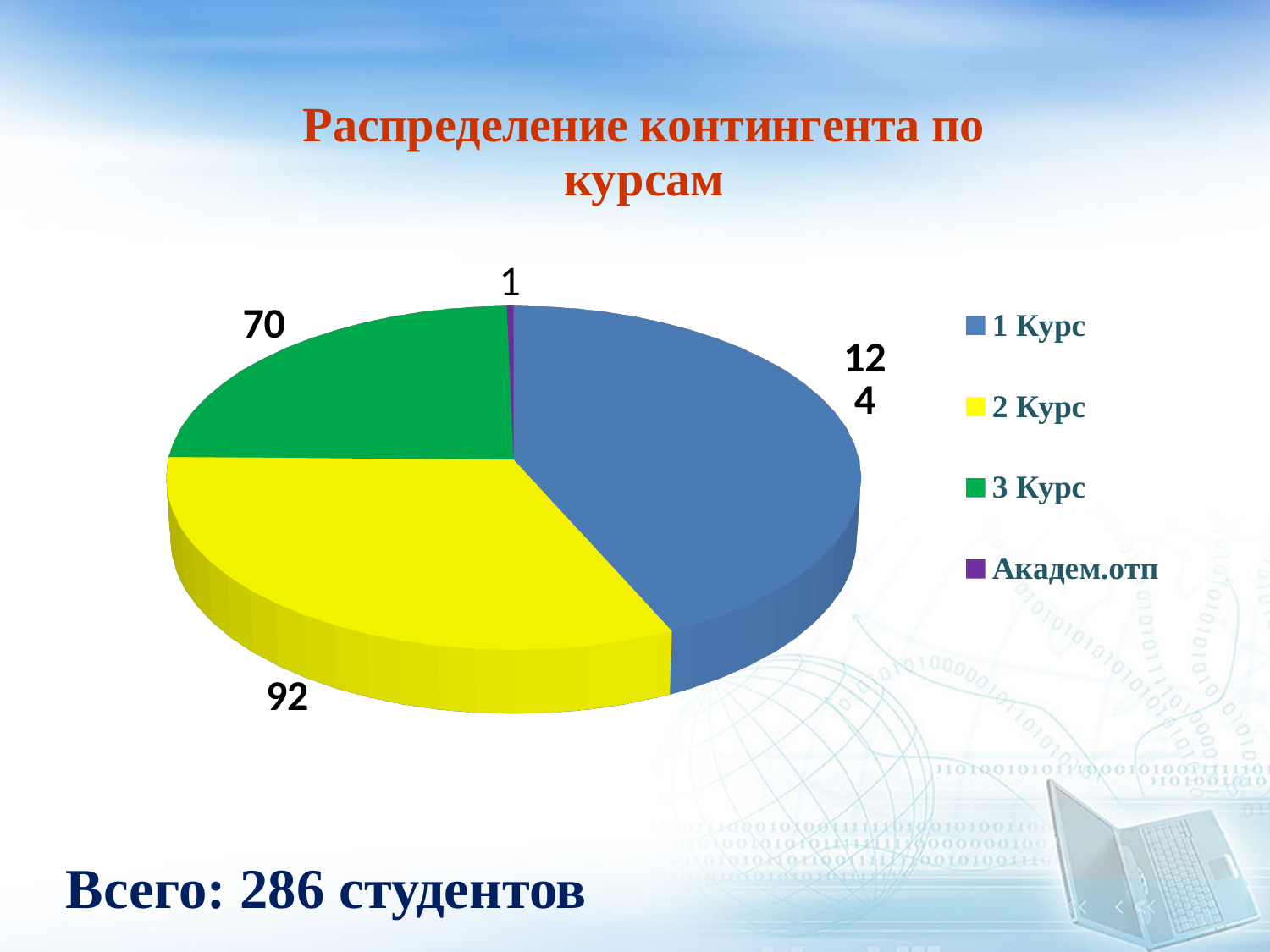
What is the value for 3 Курс? 70 What is the value for 1 Курс? 124 What colour is the slice for 2 Курс? yellow What kind of chart is shown on the slide? pie chart What is the value for Академ.отп? 1 What is the value for 2 Курс? 92 How many slices does the pie chart have? 4 What is the difference between the values for 2 Курс and 3 Курс? 22 What is the title of the chart? Распределение контингента по курсам Which category has the smallest slice? Академ.отп Which is larger, the value for 2 Курс or the value for 3 Курс? 2 Курс Which category has the largest slice? 1 Курс